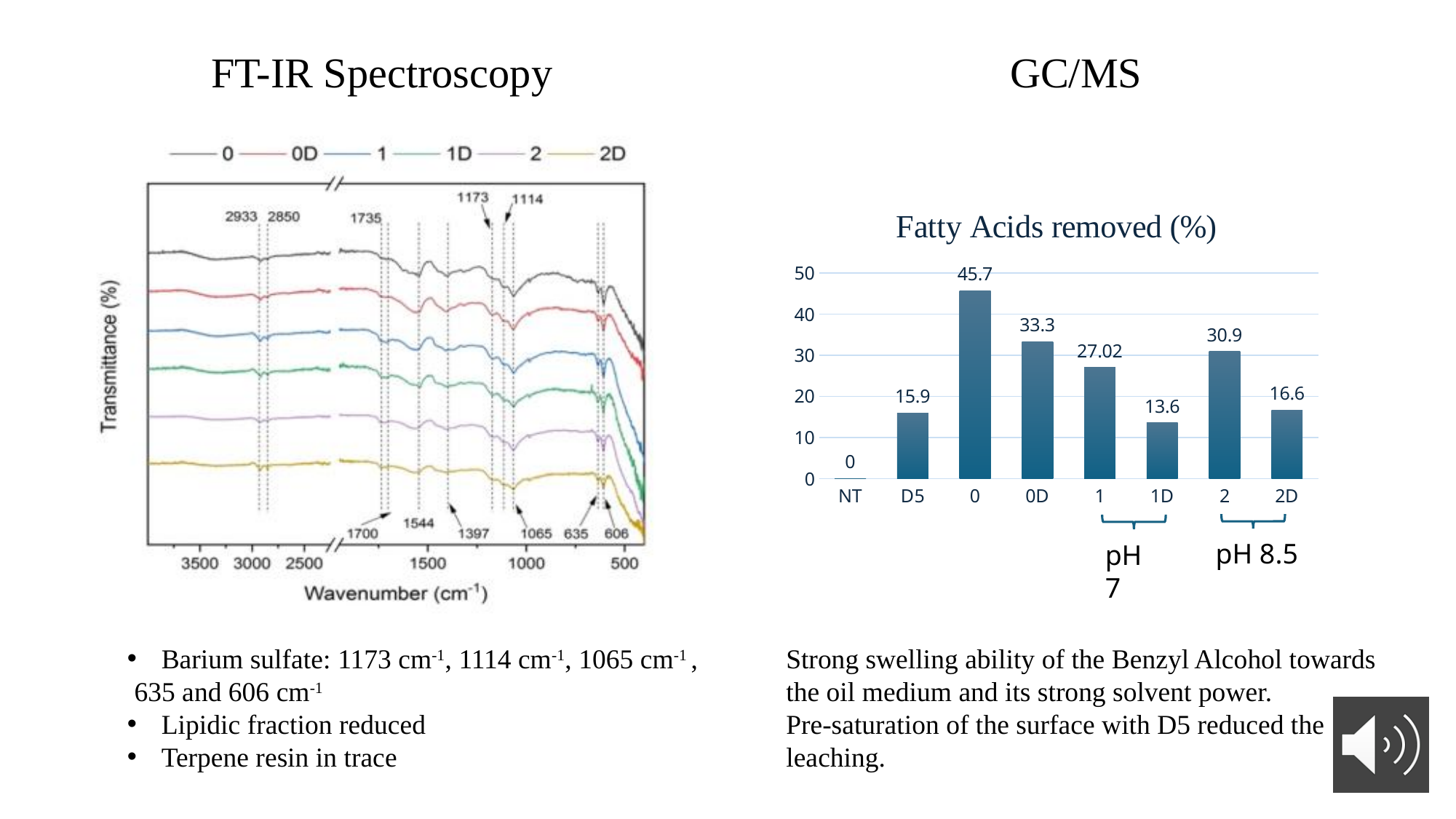
How many categories are shown on the x axis of the 'Fatty Acids removed (%)' chart? 8 In the 'Fatty Acids removed (%)' chart, is the value for 0D greater or less than 30? greater In the 'Fatty Acids removed (%)' chart, what is the value for D5? 15.9 What kind of chart is the 'Fatty Acids removed (%)' chart? bar chart In the 'Fatty Acids removed (%)' chart, what is the difference between the values for 0 and 0D? 12.4 In the 'Fatty Acids removed (%)' chart, which category has the highest value? 0 In the 'Fatty Acids removed (%)' chart, what is the value for category 0? 45.7 How many series does the legend of the FT-IR Spectroscopy chart list? 6 In the 'Fatty Acids removed (%)' chart, what is the value for 1D? 13.6 In the 'Fatty Acids removed (%)' chart, which is larger, the value for 1 or the value for 2? 2 In the 'Fatty Acids removed (%)' chart, which category has the lowest value? NT In the 'Fatty Acids removed (%)' chart, what is the difference between the values for 2 and 2D? 14.3